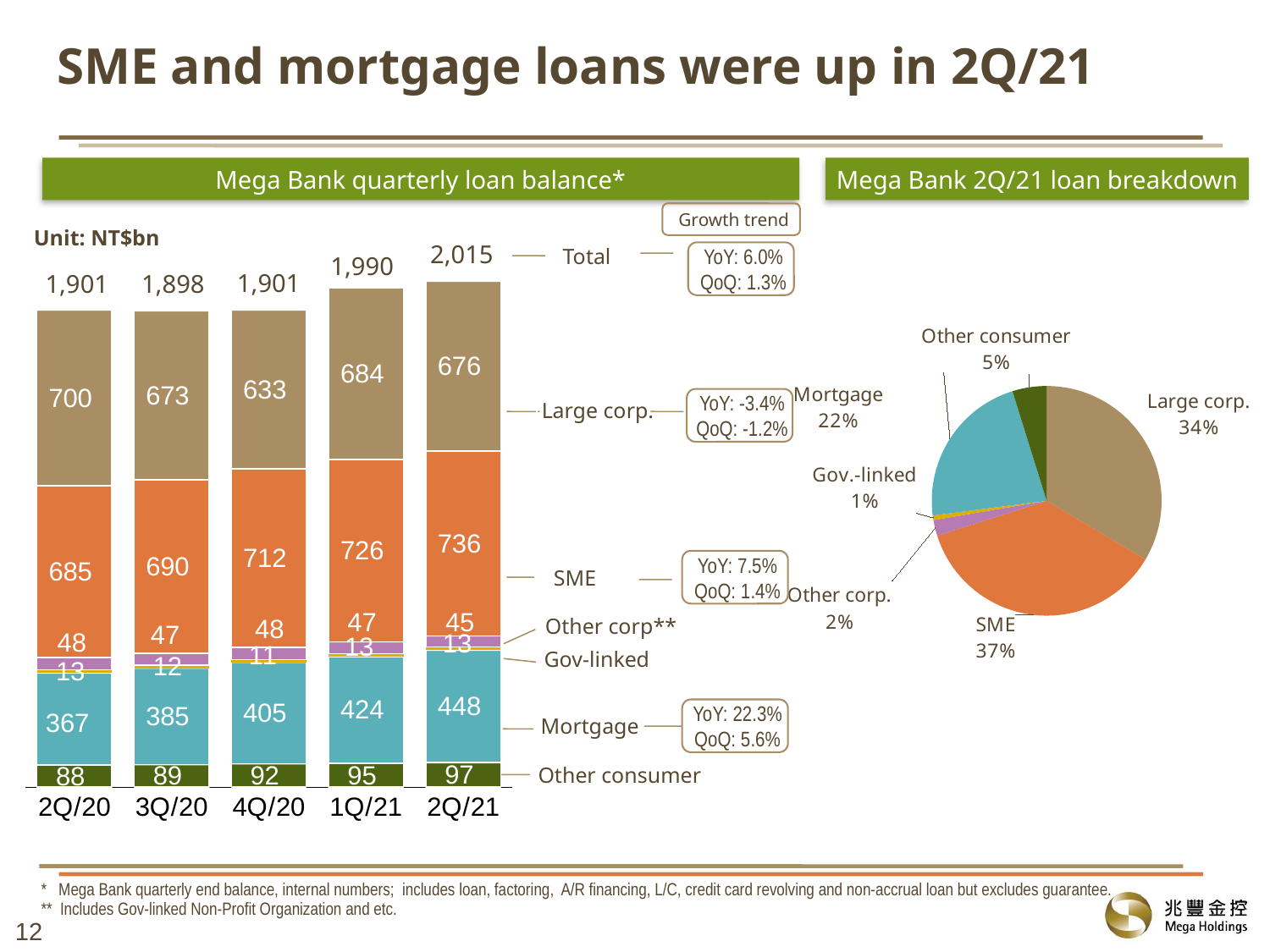
In the Mega Bank quarterly loan balance chart, what is the Large corp. value for 2Q/20? 700 In the Mega Bank quarterly loan balance chart, what is the Mortgage value for 4Q/20? 405 In the Mega Bank quarterly loan balance chart, is the Large corp. value larger in 1Q/21 or in 2Q/21? 1Q/21 In the Mega Bank quarterly loan balance chart, what is the difference between the SME value in 2Q/21 and in 2Q/20? 51 In the Mega Bank quarterly loan balance chart, what is the YoY growth shown for Mortgage? 22.3% In the Mega Bank quarterly loan balance chart, how does the Mortgage value change from 2Q/20 to 2Q/21? It rises In the Mega Bank quarterly loan balance chart, what is the total loan balance for 2Q/21? 2,015 In the Mega Bank 2Q/21 loan breakdown pie chart, which category has the smallest share? Gov.-linked In the Mega Bank 2Q/21 loan breakdown pie chart, what share does SME account for? 37% What kind of chart is the Mega Bank quarterly loan balance chart? Stacked bar chart In the Mega Bank quarterly loan balance chart, which quarter has the highest total loan balance? 2Q/21 In the Mega Bank quarterly loan balance chart, how many quarters are shown on the x axis? 5